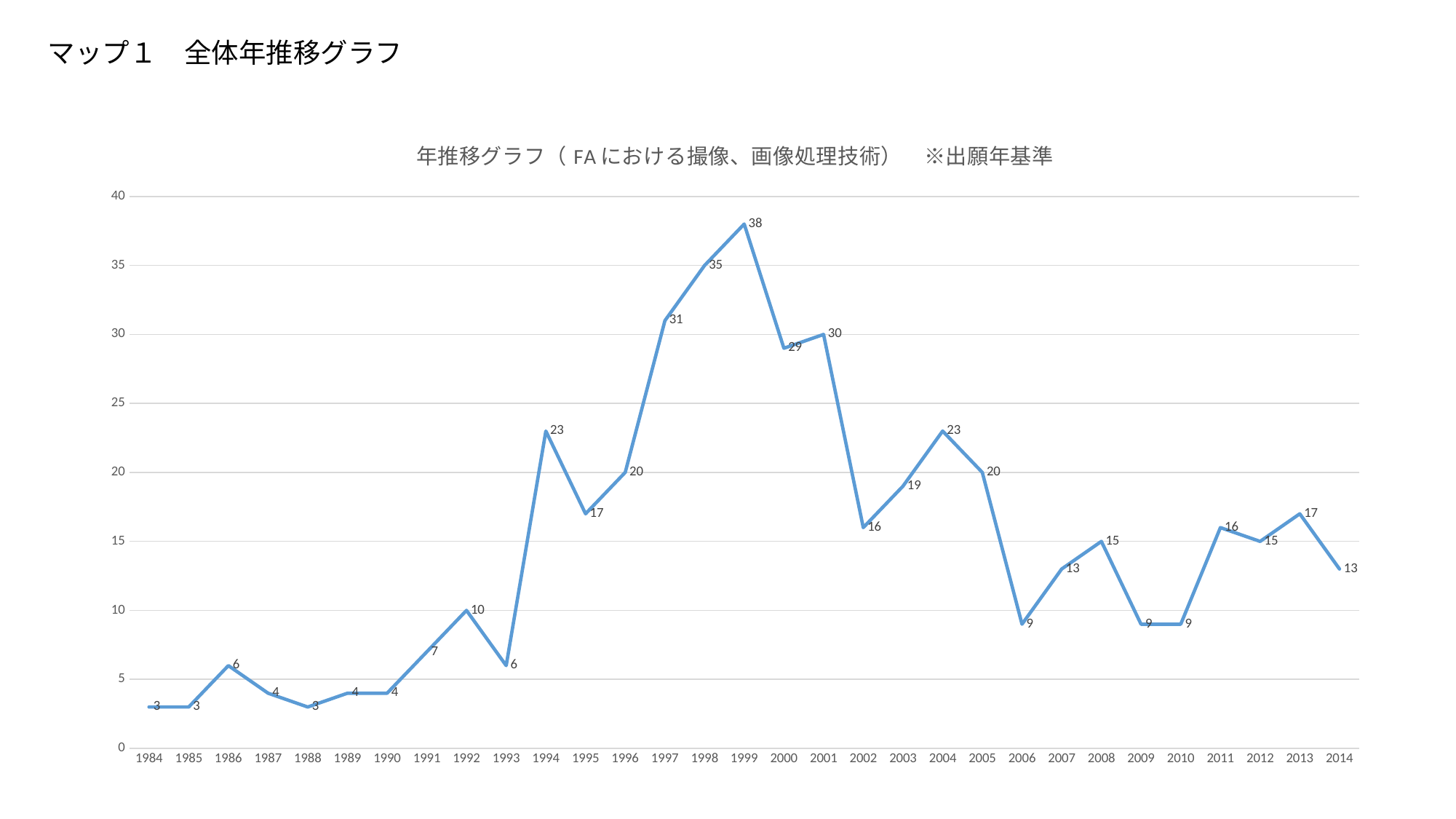
Do the values rise or fall from 1993 to 1999? rise How many years are plotted on the x axis? 31 Which year has the highest value? 1999 Is the value for 1998 greater or less than 30? greater What is the difference between the values for 1999 and 2000? 9 What is the value for 2006? 9 What is the value for 1999? 38 What is the value for 1994? 23 What type of chart is shown on the slide? line chart What is the difference between the values for 2004 and 2002? 7 What is the value for 2014? 13 Which is larger, the value for 1997 or the value for 2001? 1997